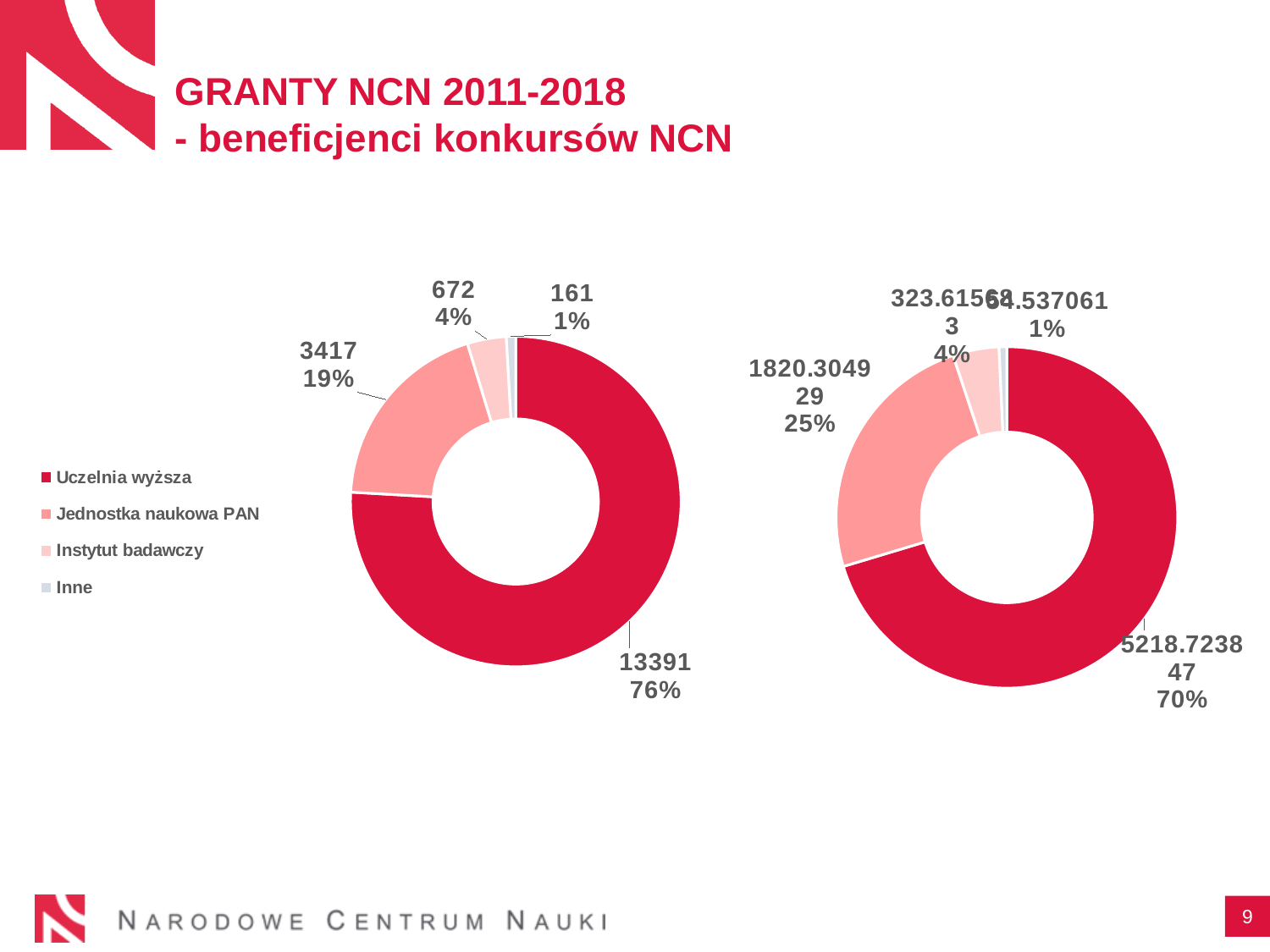
In the right chart, what share of the total does Uczelnia wyższa have? 70% In the left chart, which category has the smallest slice? Inne In the left chart, which is larger: the value for Instytut badawczy or the value for Inne? Instytut badawczy In the right chart, what is the value shown for Jednostka naukowa PAN? 1820.304929 In the left chart, what is the value shown for Jednostka naukowa PAN? 3417 In the left chart, what is the value shown for Inne? 161 In the left chart, what is the value shown for Uczelnia wyższa? 13391 In the left chart, what is the difference between the values for Uczelnia wyższa and Jednostka naukowa PAN? 9974 How many categories does the legend list? 4 In the left chart, which category has the largest slice? Uczelnia wyższa What type of chart is used on this slide? Doughnut (pie) chart In the left chart, what share of the total does Jednostka naukowa PAN have? 19%